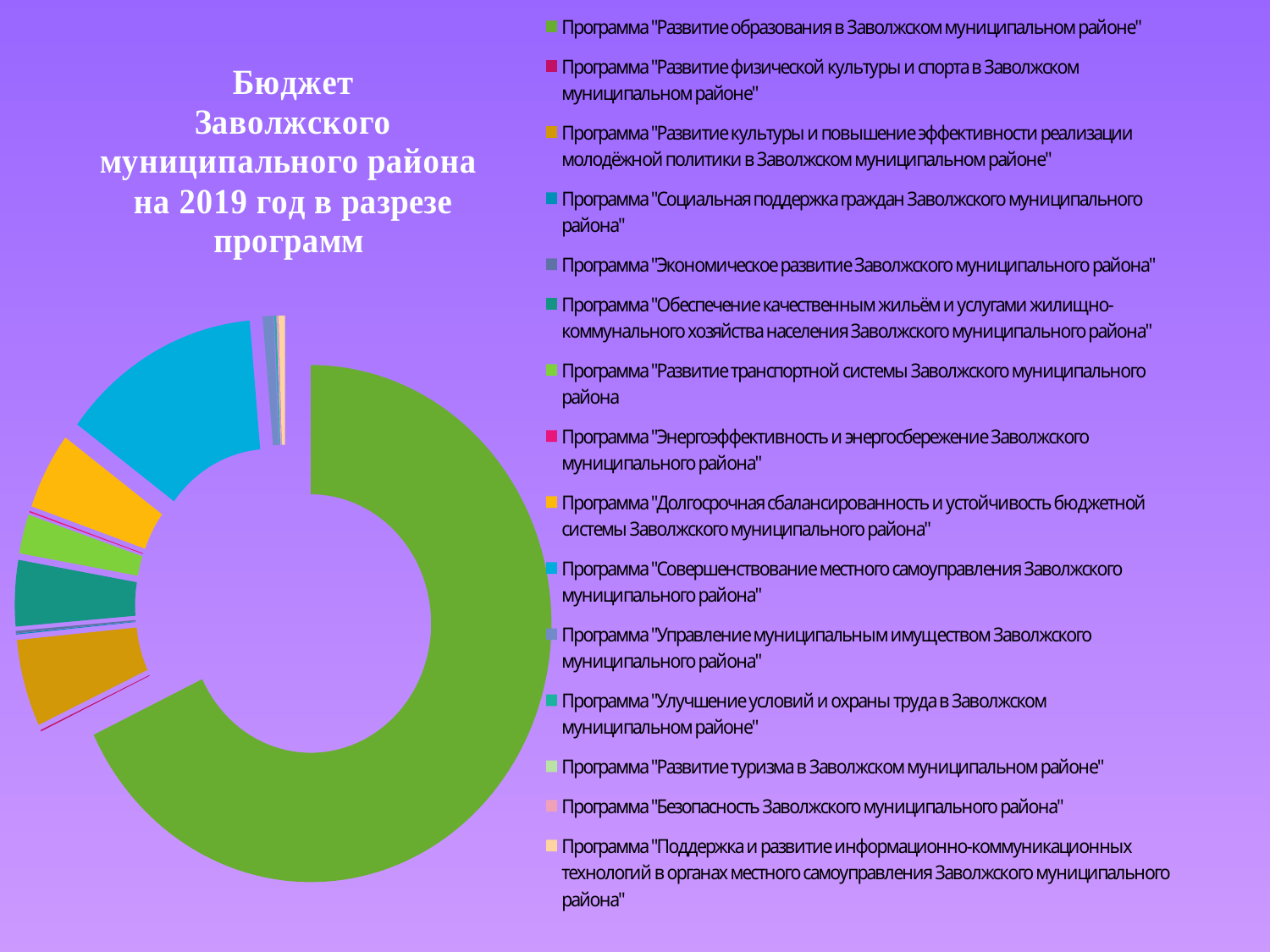
Which programme has the second-largest slice in the chart? Программа "Совершенствование местного самоуправления Заволжского муниципального района" What is the title of the chart on the slide? Бюджет Заволжского муниципального района на 2019 год в разрезе программ Which slice is larger: "Социальная поддержка граждан" or "Долгосрочная сбалансированность и устойчивость бюджетной системы"? Долгосрочная сбалансированность и устойчивость бюджетной системы What kind of chart is shown on the slide? Doughnut (pie) chart Which programme is listed first in the legend? Программа "Развитие образования в Заволжском муниципальном районе" Which programme has the largest share of the budget in the chart? Программа "Развитие образования в Заволжском муниципальном районе" What colour is the slice for the programme "Развитие образования в Заволжском муниципальном районе"? Green How many programmes are listed in the chart's legend? 15 Which slice is larger: "Развитие образования" or "Социальная поддержка граждан"? Развитие образования